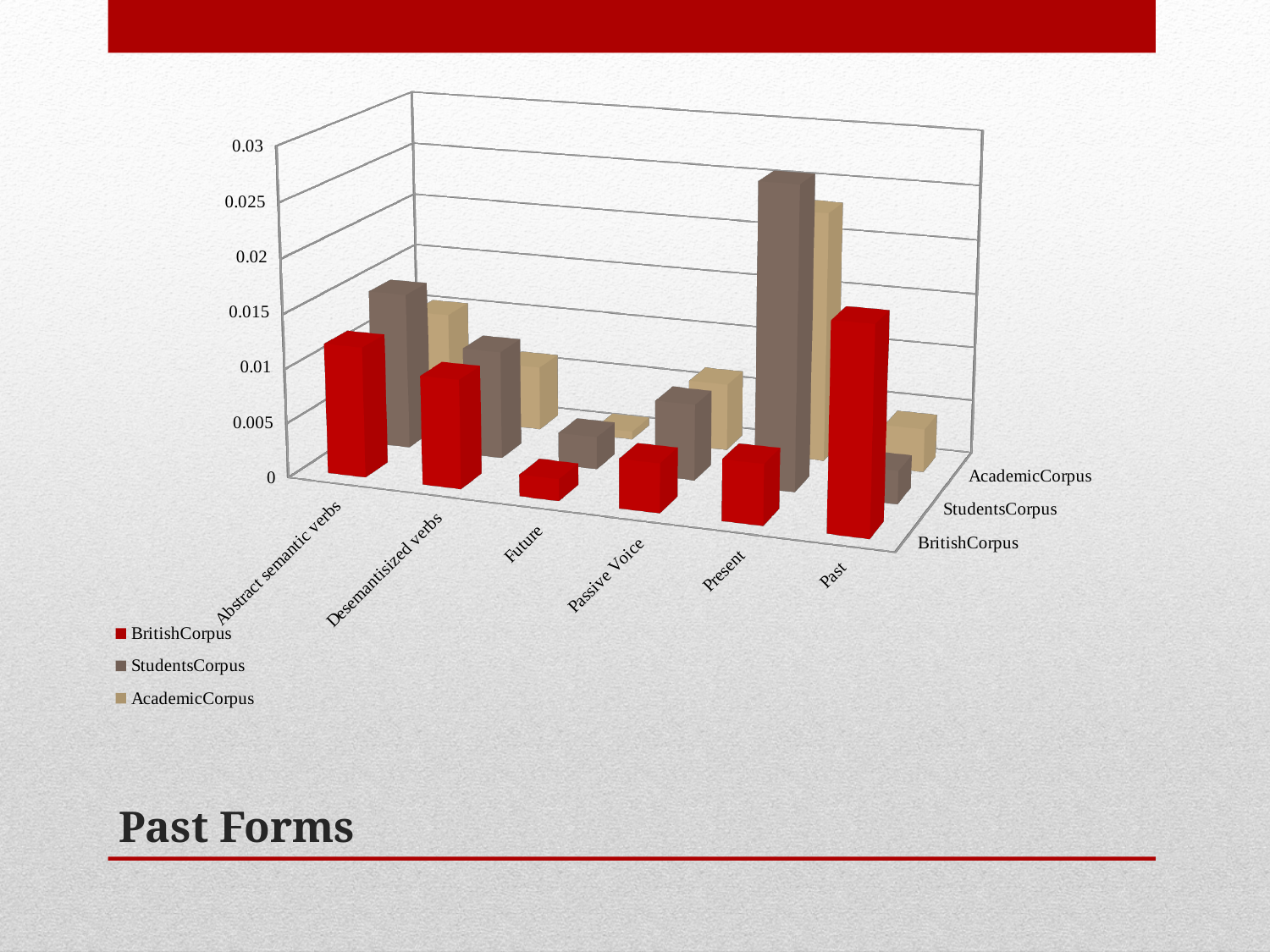
What colour are the bars for the BritishCorpus series? red Is the BritishCorpus value for Future greater or less than 0.005? less Which category has the lowest value for the AcademicCorpus series? Future How many categories are shown along the x axis of the chart? 6 Which category has the highest value for the BritishCorpus series? Past For the Present category, which series has the larger value: StudentsCorpus or AcademicCorpus? StudentsCorpus Is the StudentsCorpus value for Present greater or less than 0.02? greater Which category has the lowest value for the BritishCorpus series? Future Which category has the highest value for the AcademicCorpus series? Present What kind of chart is shown on the slide? bar chart How many series does the chart's legend list? 3 Which category has the highest value for the StudentsCorpus series? Present